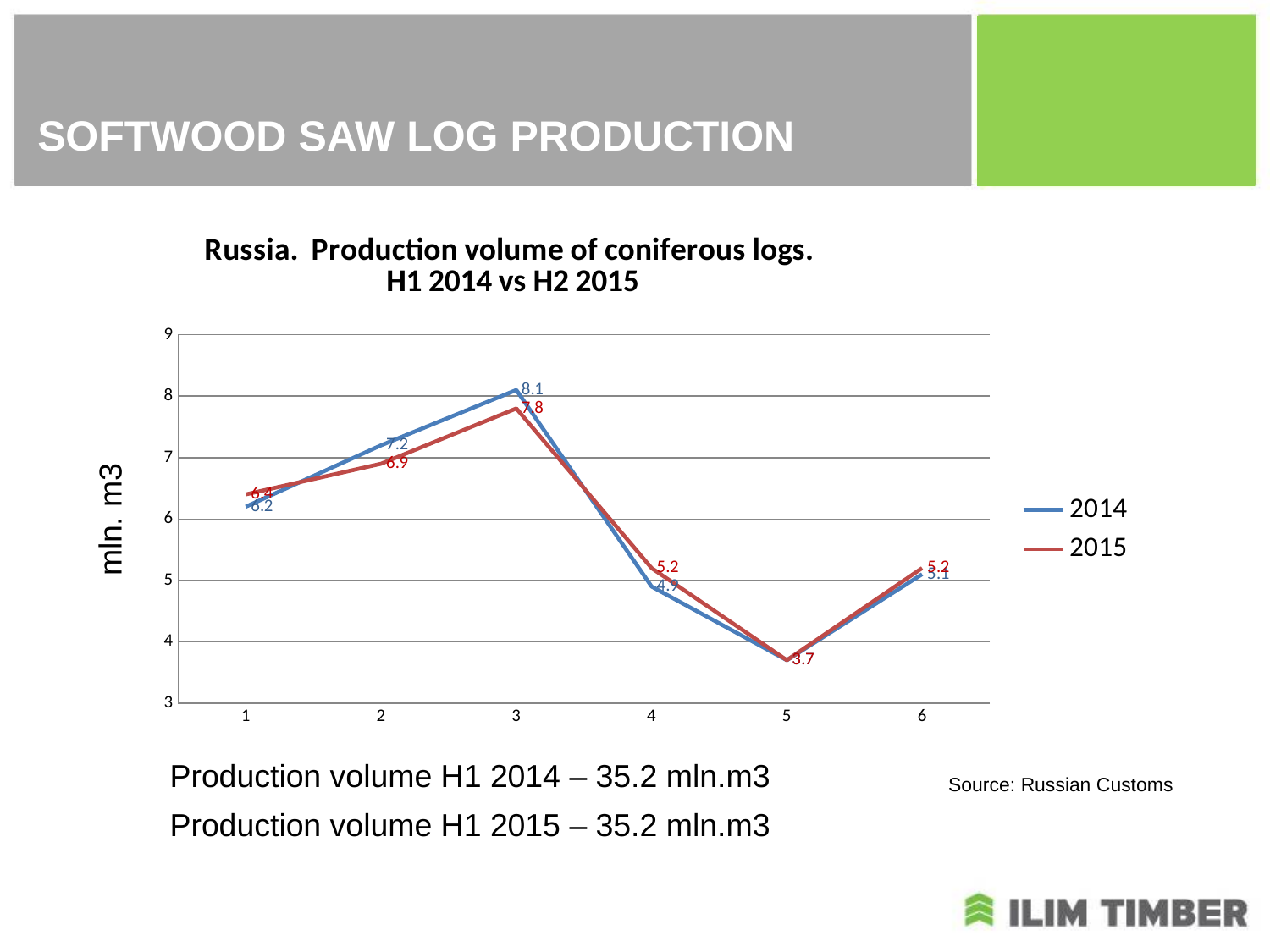
Which series has the larger value at point 4, 2014 or 2015? 2015 What type of chart is shown on the slide? line chart Does the 2015 series rise or fall from point 3 to point 5? fall At which x-axis point does the 2015 series reach its lowest value? 5 What is the label on the vertical axis? mln. m3 What is the 2014 value at point 3? 8.1 How many points are plotted along the x axis for each series? 6 At which x-axis point does the 2014 series reach its highest value? 3 How many series does the legend list? 2 What is the 2014 value at point 1? 6.2 What is the 2015 value at point 2? 6.9 What is the difference between the 2014 and 2015 values at point 3? 0.3